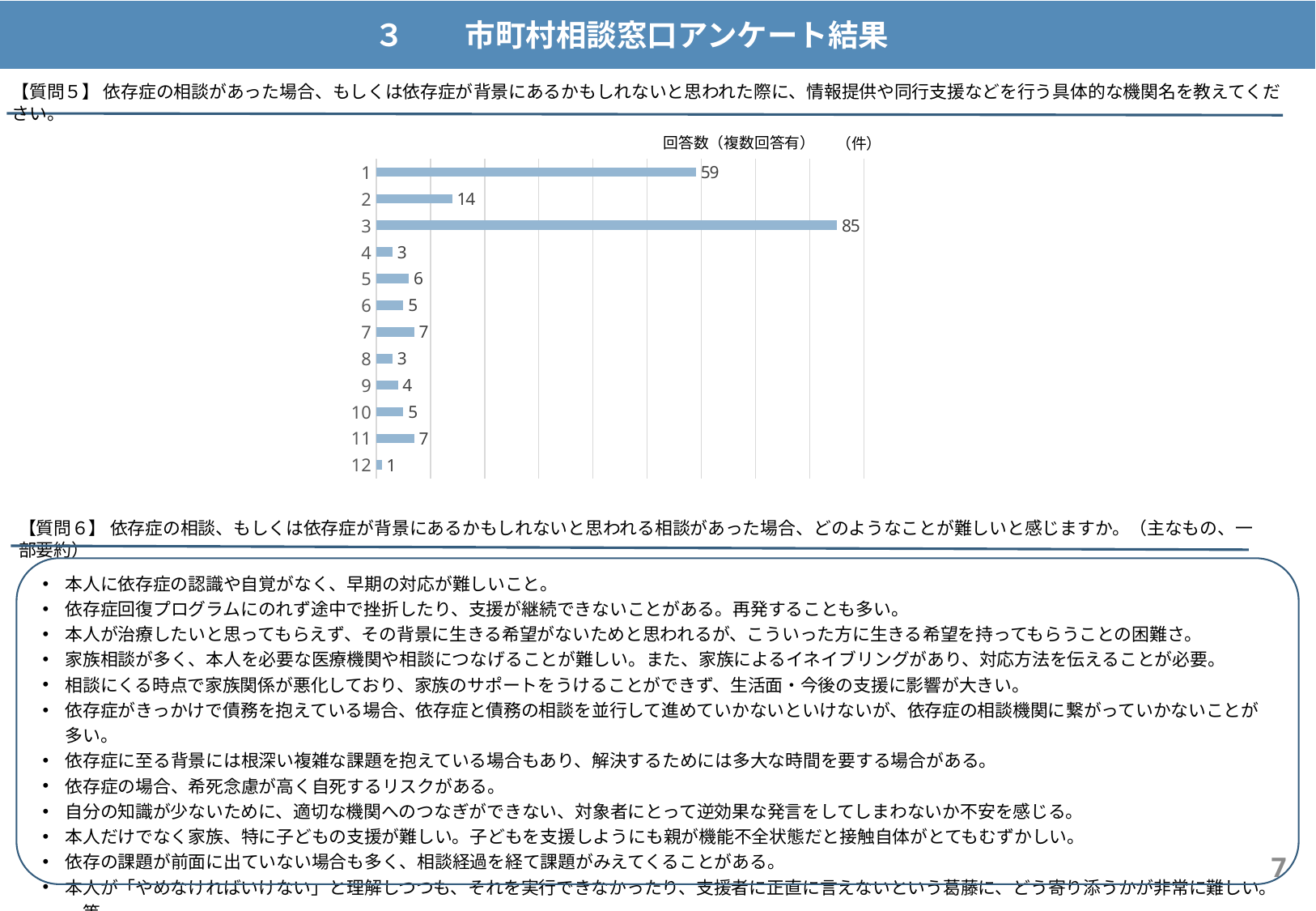
Which category has the highest value in the chart? 3 What is the value for category 2 in the chart? 14 What type of chart is shown on the slide? bar chart What is the difference between the values for category 3 and category 1? 26 What is the value for category 1 in the chart? 59 What is the value for category 3 in the chart? 85 What is the difference between the values for category 1 and category 2? 45 What is the value for category 12 in the chart? 1 Which is larger, the value for category 5 or the value for category 9? category 5 What is the title of the chart? 回答数（複数回答有） （件） Which category has the lowest value in the chart? 12 How many categories are plotted in the chart? 12